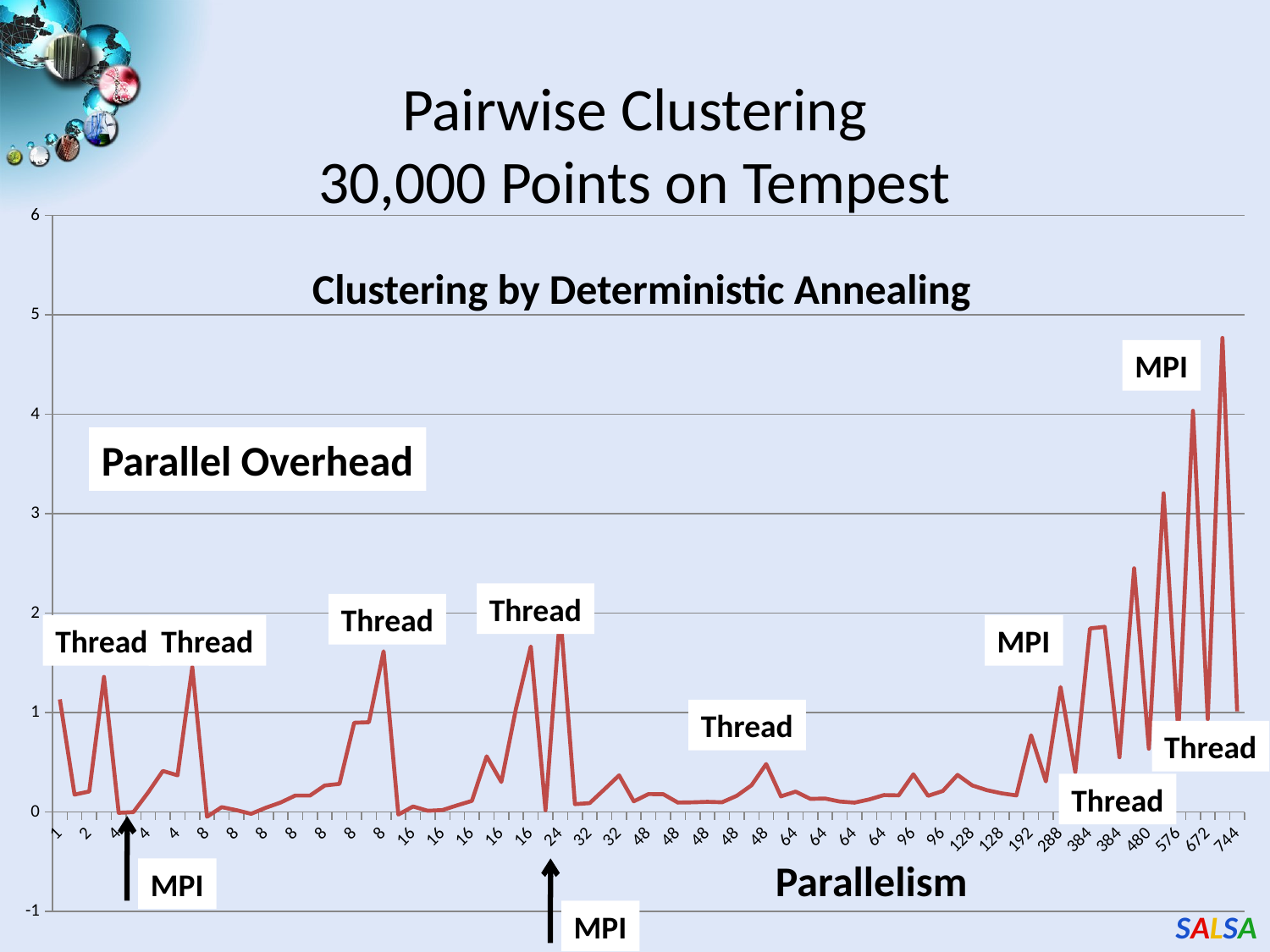
Which has the larger value, parallelism 744 or parallelism 672? 744 Is the value at parallelism 128 greater or less than 1? less Is the value at parallelism 480 greater or less than 2? greater Is the value at parallelism 744 greater or less than 4? greater What is the title printed inside the chart area? Clustering by Deterministic Annealing What kind of chart is shown on the slide? line chart Do the peaks of the line generally rise or fall as parallelism increases toward the right end of the x axis? rise What label is given to the x axis of the chart? Parallelism At which parallelism value on the x axis does the line reach its highest point? 744